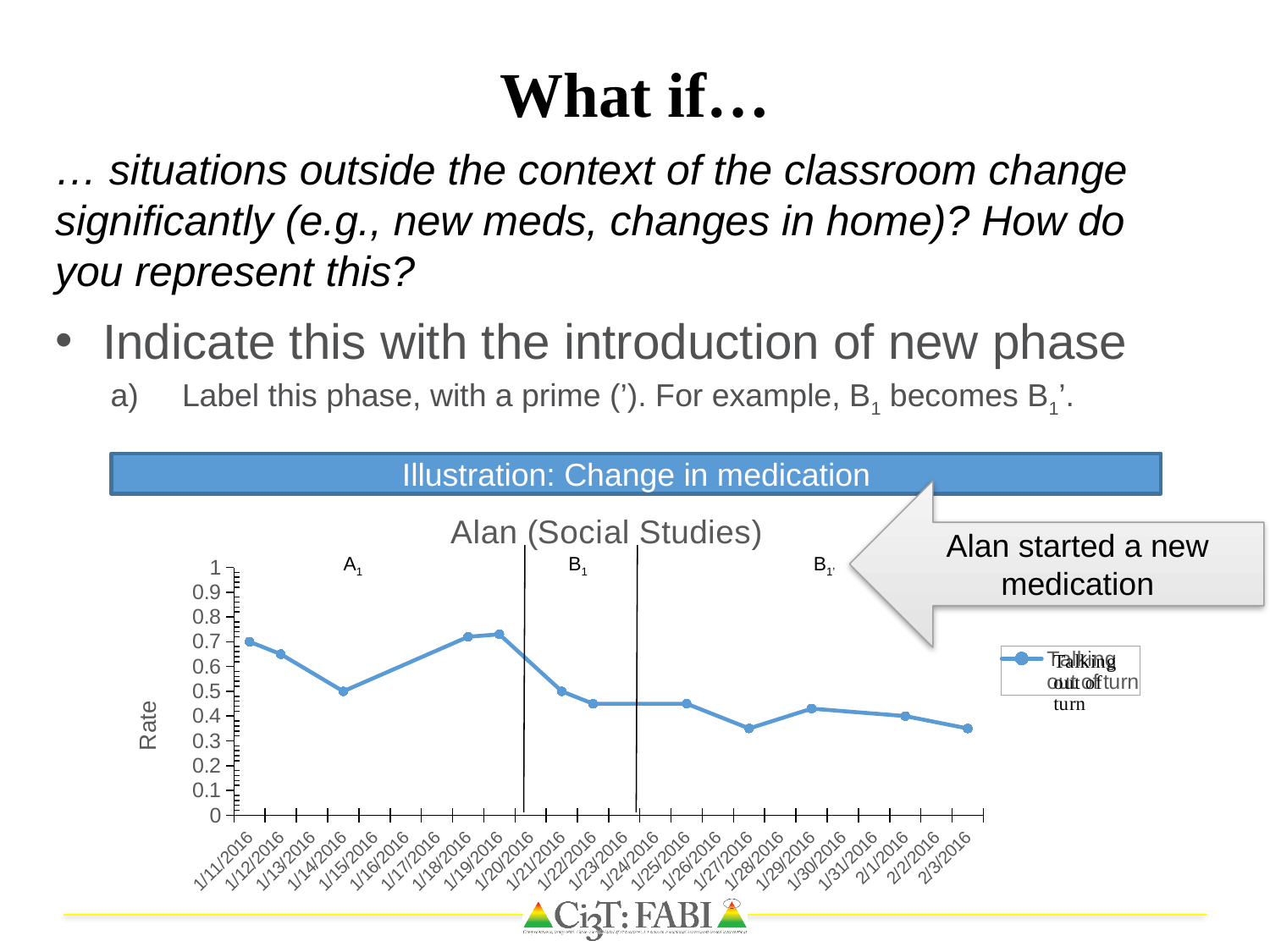
Is the value for 1/11/2016 greater or less than 0.5? greater Is the value for 1/19/2016 greater or less than 0.6? greater How many series does the legend list? 1 What kind of chart is shown on the slide? line chart Do the values generally rise or fall from 1/21/2016 to 2/3/2016? fall What is the title of the chart? Alan (Social Studies) Do the values rise or fall from 1/14/2016 to 1/19/2016? rise What series does the chart's legend list? Talking out of turn How many dates are labelled along the x axis? 24 Is the value for 1/14/2016 greater or less than 0.6? less Which has the larger value, 1/19/2016 or 1/27/2016? 1/19/2016